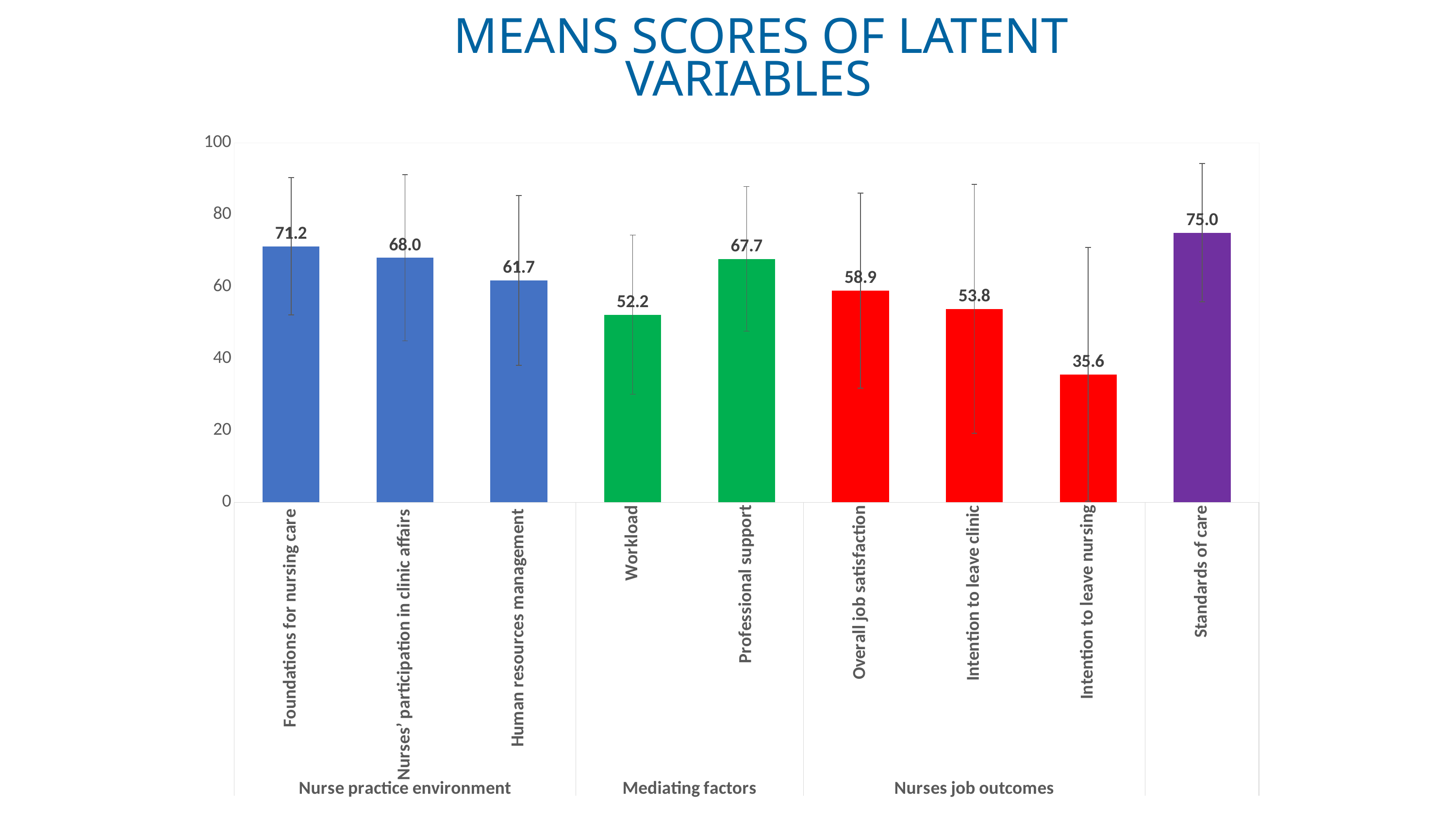
How many bars are plotted on the chart? 9 What is the mean score for Intention to leave nursing? 35.6 Which variable has the lowest mean score? Intention to leave nursing Which variable has the highest mean score? Standards of care What is the difference between the mean scores for Foundations for nursing care and Human resources management? 9.5 Which has a higher mean score, Professional support or Overall job satisfaction? Professional support What kind of chart is shown on the slide? Bar chart What is the title of the chart? MEANS SCORES OF LATENT VARIABLES What is the mean score for Foundations for nursing care? 71.2 What is the mean score for Workload? 52.2 Which group label contains the bars for Workload and Professional support? Mediating factors What is the mean score for Standards of care? 75.0